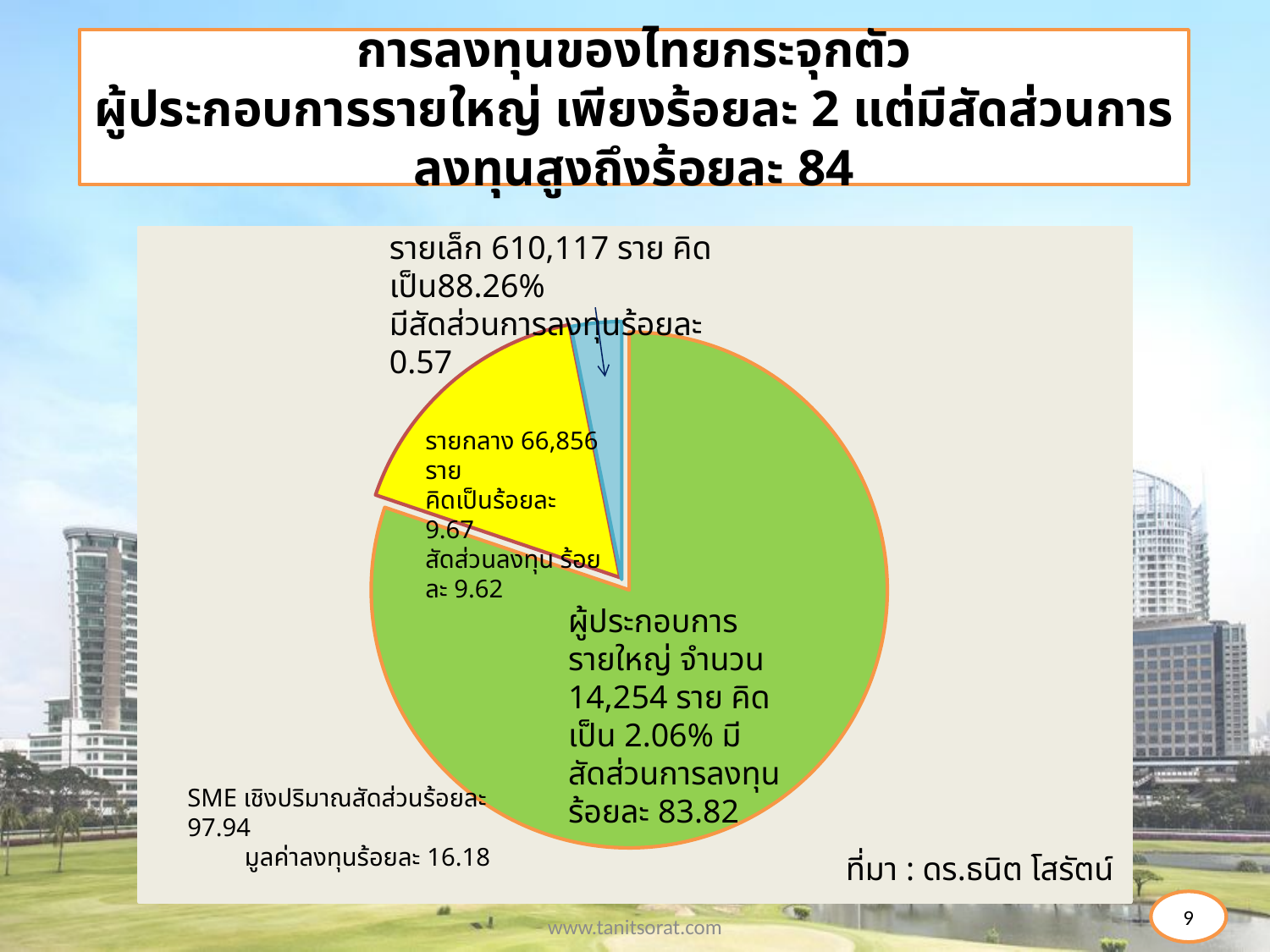
What percentage of enterprises are small enterprises (รายเล็ก) according to the label? 88.26% How many slices does the pie chart have? 3 How many small enterprises (รายเล็ก) does the chart label report? 610,117 ราย How many medium enterprises (รายกลาง) are there according to the chart label? 66,856 ราย What investment share (สัดส่วนลงทุน) is given for medium enterprises (รายกลาง)? ร้อยละ 9.62 Which has the larger investment share: large enterprises (รายใหญ่) or medium enterprises (รายกลาง)? รายใหญ่ (large enterprises) What is the difference between the investment share of large enterprises (83.82) and medium enterprises (9.62)? 74.20 What kind of chart is shown on the slide? pie chart According to the chart label, how many large enterprises (ผู้ประกอบการรายใหญ่) are there? 14,254 ราย What investment share (สัดส่วนการลงทุน) is given for large enterprises (รายใหญ่)? ร้อยละ 83.82 Which group has the largest slice in the pie chart? ผู้ประกอบการรายใหญ่ (large enterprises) What colour is the slice for large enterprises (ผู้ประกอบการรายใหญ่)? green